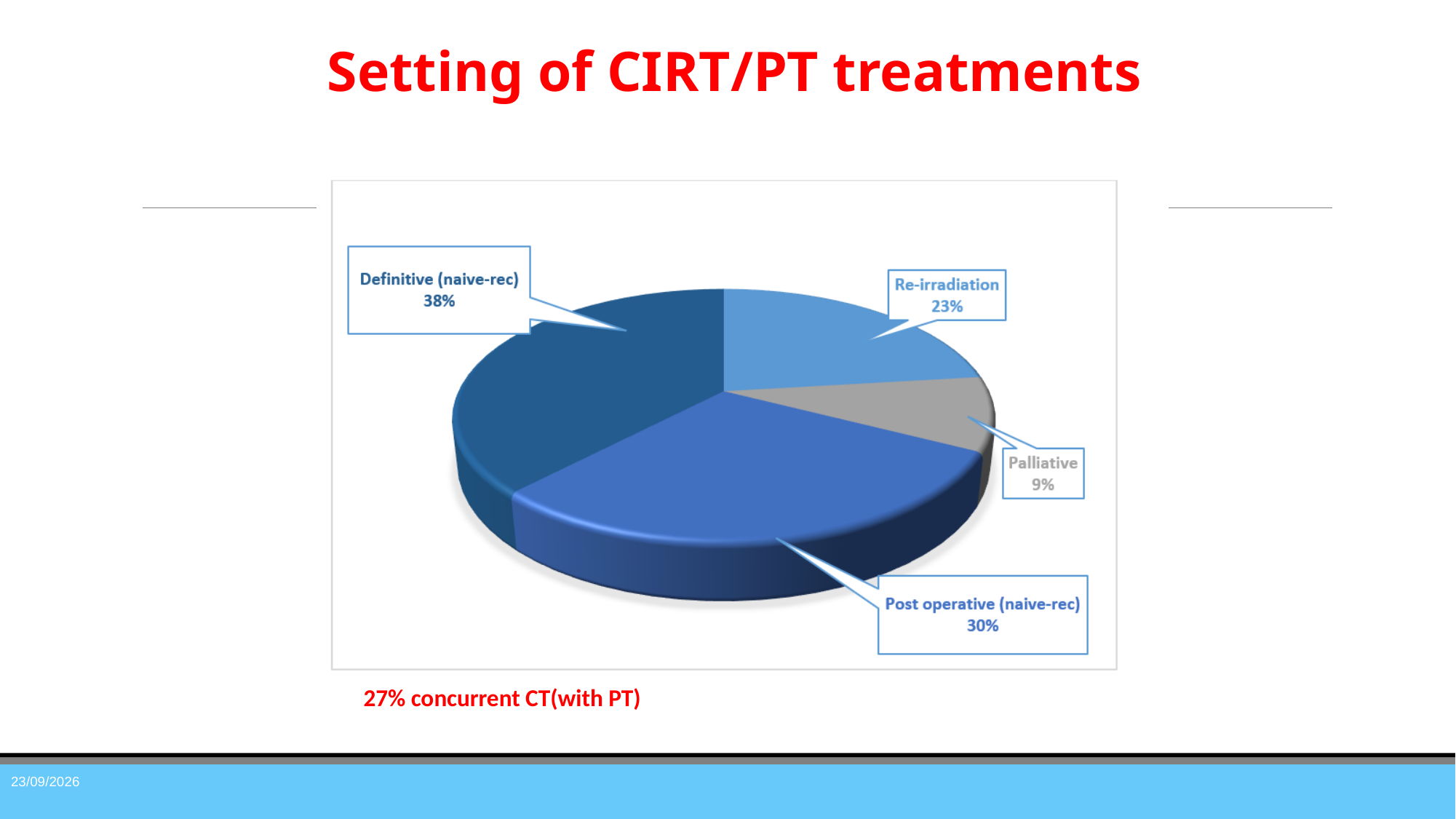
How many slices does the pie chart have? 4 What share of treatments is Definitive (naive-rec)? 38% Which is larger, the Re-irradiation share or the Palliative share? Re-irradiation Which treatment setting has the smallest share of the pie? Palliative What is the combined share of Definitive (naive-rec) and Post operative (naive-rec)? 68% Which treatment setting has the largest share of the pie? Definitive (naive-rec) What share of treatments is Post operative (naive-rec)? 30% What share of treatments is Re-irradiation? 23% What kind of chart is shown on the slide? Pie chart What colour is the Palliative slice? Grey What is the difference in percentage points between Definitive (naive-rec) and Post operative (naive-rec)? 8 What share of treatments is Palliative? 9%